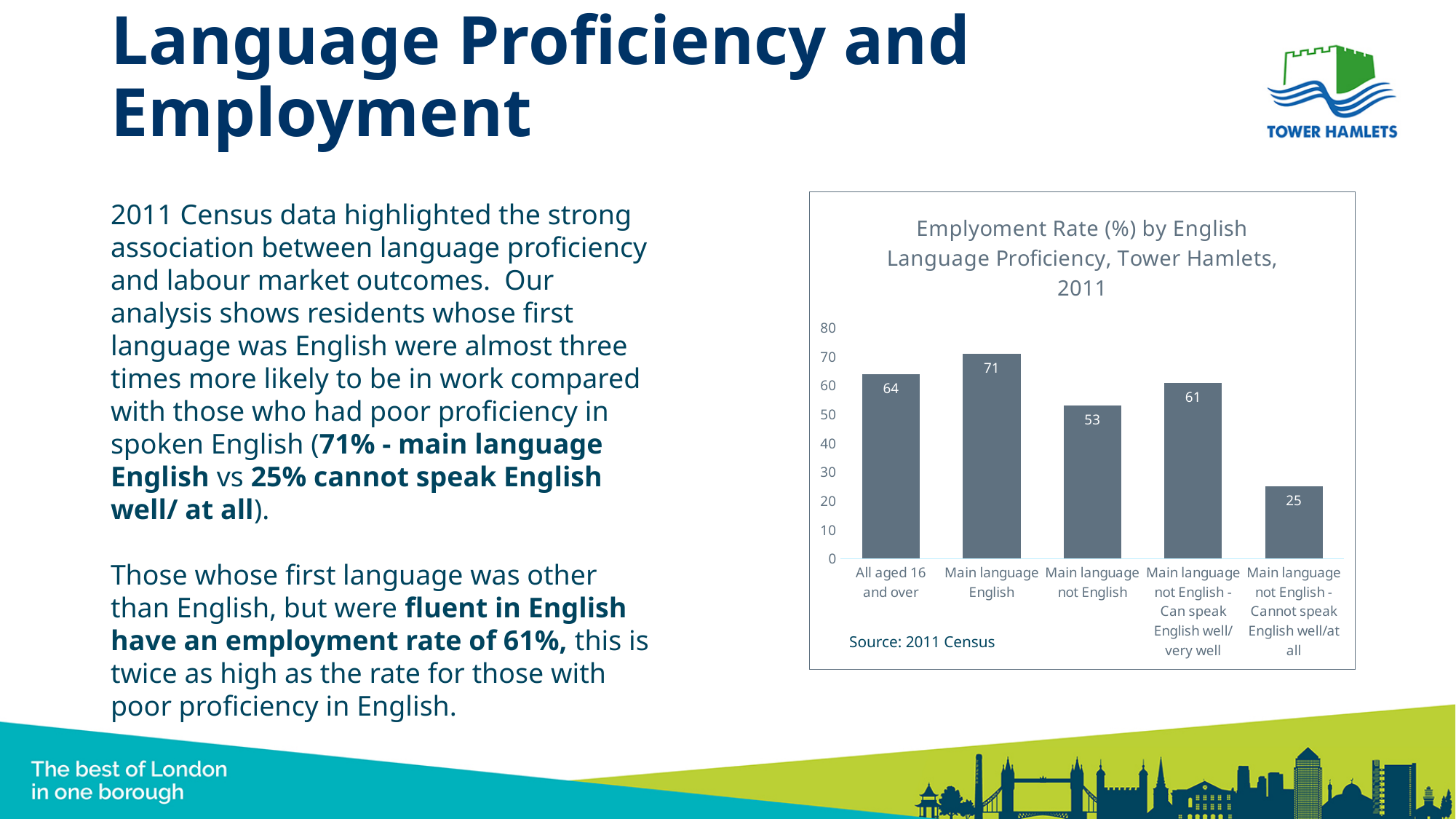
What is the difference in employment rate between 'Main language English' and 'Main language not English - Cannot speak English well/at all'? 46 Which category has the highest employment rate? Main language English What type of chart is shown on the slide? Bar chart What is the employment rate for residents whose main language is not English and who cannot speak English well/at all? 25 What is the source cited on the chart? 2011 Census What is the employment rate for residents whose main language is English? 71 Which has a higher employment rate: 'Main language not English' or 'Main language not English - Can speak English well/very well'? Main language not English - Can speak English well/very well Which category has the lowest employment rate? Main language not English - Cannot speak English well/at all What is the difference in employment rate between 'All aged 16 and over' and 'Main language not English'? 11 What is the employment rate for residents whose main language is not English but who can speak English well/very well? 61 How many categories are shown on the chart? 5 What is the employment rate for 'All aged 16 and over'? 64